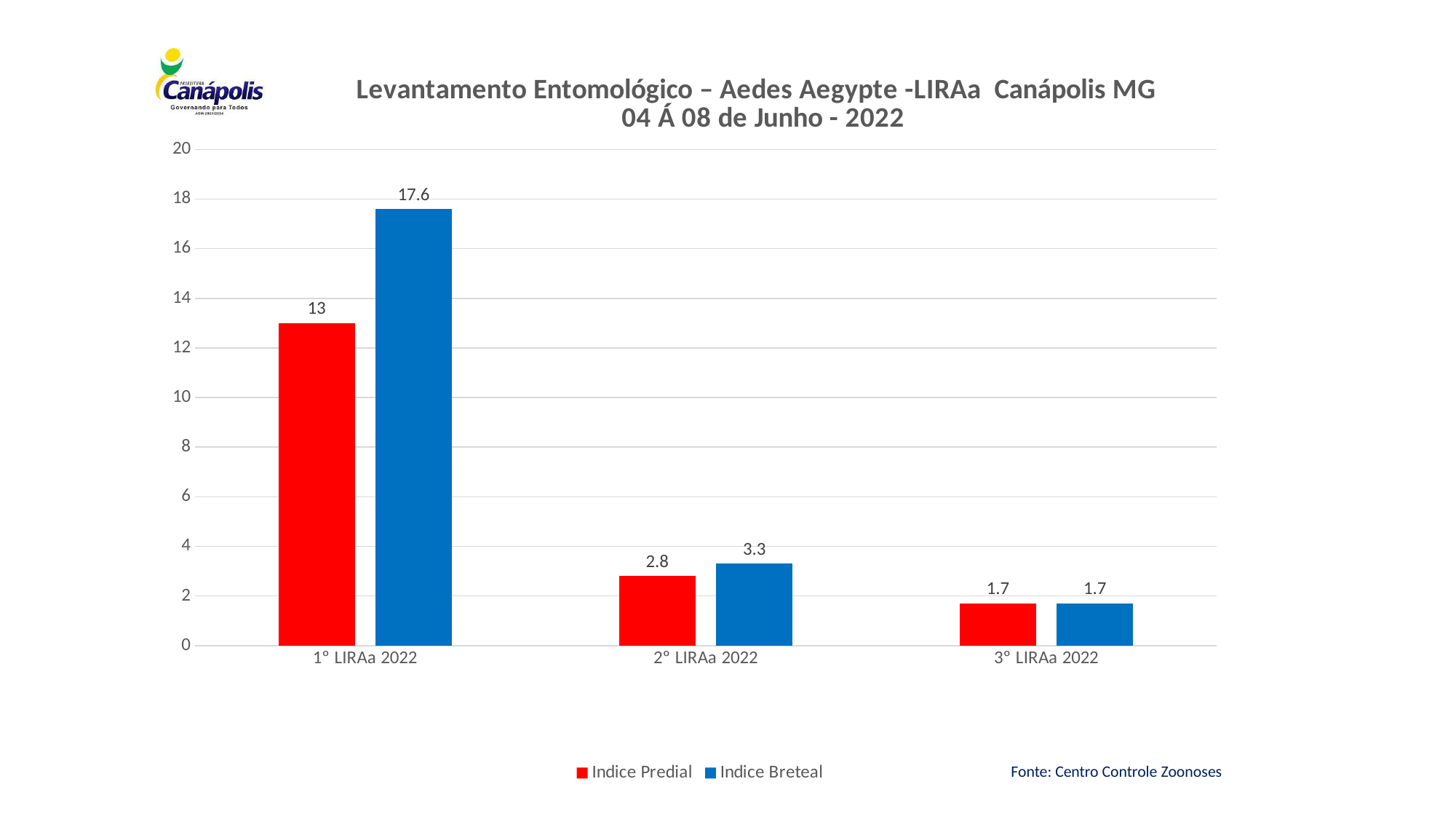
Do the Indice Predial values rise or fall from 1° LIRAa 2022 to 3° LIRAa 2022? Fall How many series does the legend list? 2 What is the Indice Predial value for 1° LIRAa 2022? 13 What is the Indice Breteal value for 3° LIRAa 2022? 1.7 What is the difference between the Indice Breteal and Indice Predial values for 1° LIRAa 2022? 4.6 What is the Indice Breteal value for 1° LIRAa 2022? 17.6 How many categories are shown on the x axis? 3 What is the Indice Predial value for 2° LIRAa 2022? 2.8 What kind of chart is shown on the slide? Bar chart Which category has the highest Indice Breteal value? 1° LIRAa 2022 Which is larger for 2° LIRAa 2022, Indice Predial or Indice Breteal? Indice Breteal Which category has the lowest Indice Predial value? 3° LIRAa 2022